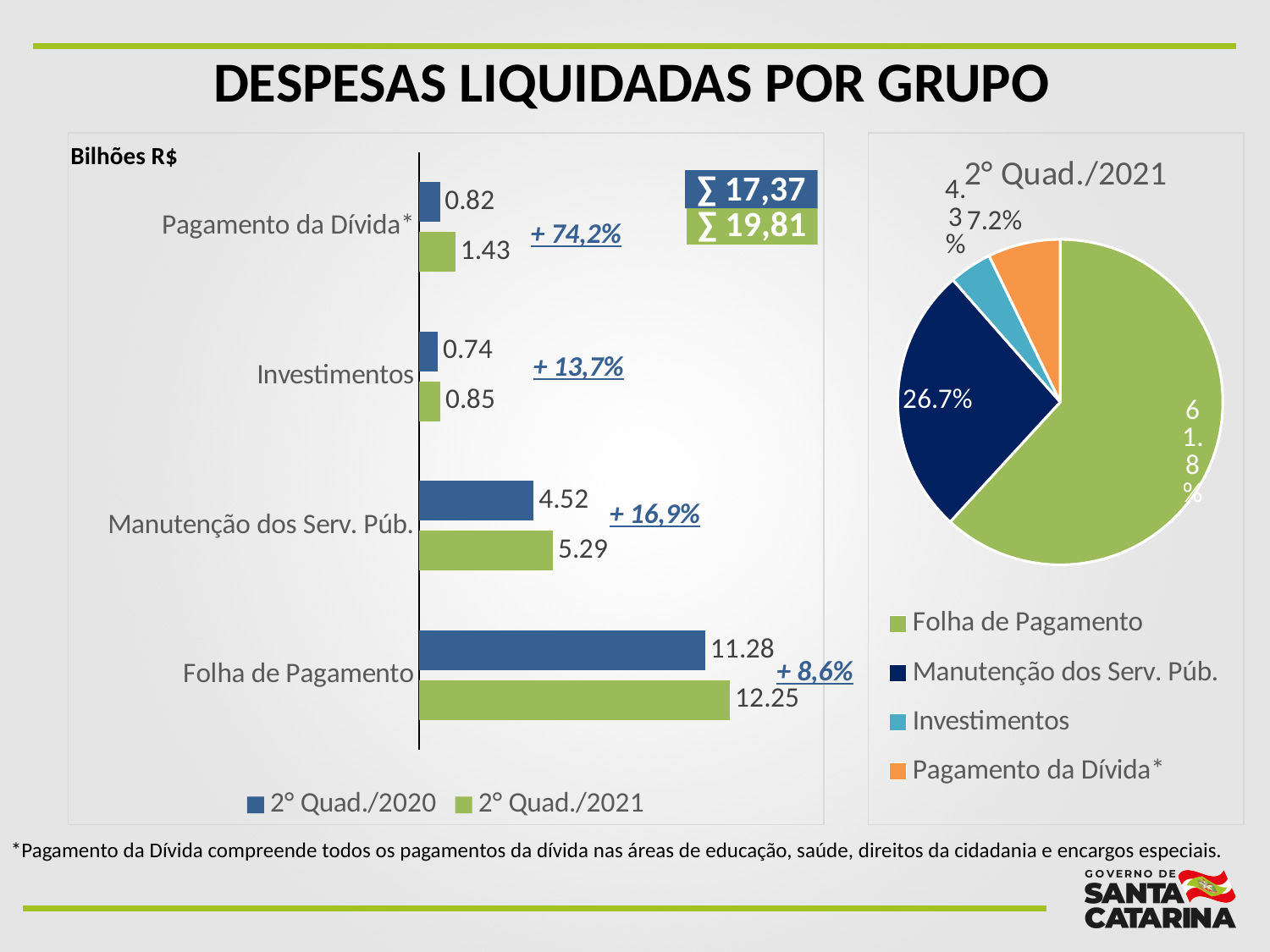
In the left bar chart, which is larger for Investimentos: the 2° Quad./2020 value or the 2° Quad./2021 value? 2° Quad./2021 In the left bar chart, what is the value for Pagamento da Dívida in 2° Quad./2021? 1.43 In the left bar chart, what is the difference between the 2° Quad./2021 and 2° Quad./2020 values for Manutenção dos Serv. Púb.? 0.77 In the pie chart titled 2° Quad./2021, what share does Manutenção dos Serv. Púb. have? 26.7% In the left bar chart, what is the value for Manutenção dos Serv. Púb. in 2° Quad./2020? 4.52 In the left bar chart, what is the value for Folha de Pagamento in 2° Quad./2021? 12.25 What kind of chart is the chart on the left? Bar chart In the pie chart titled 2° Quad./2021, which category has the largest slice? Folha de Pagamento In the left bar chart, which category has the lowest value in 2° Quad./2020? Investimentos How many series does the legend of the left bar chart list? 2 In the pie chart titled 2° Quad./2021, what share does Pagamento da Dívida have? 7.2% In the left bar chart, which category has the highest value in 2° Quad./2021? Folha de Pagamento